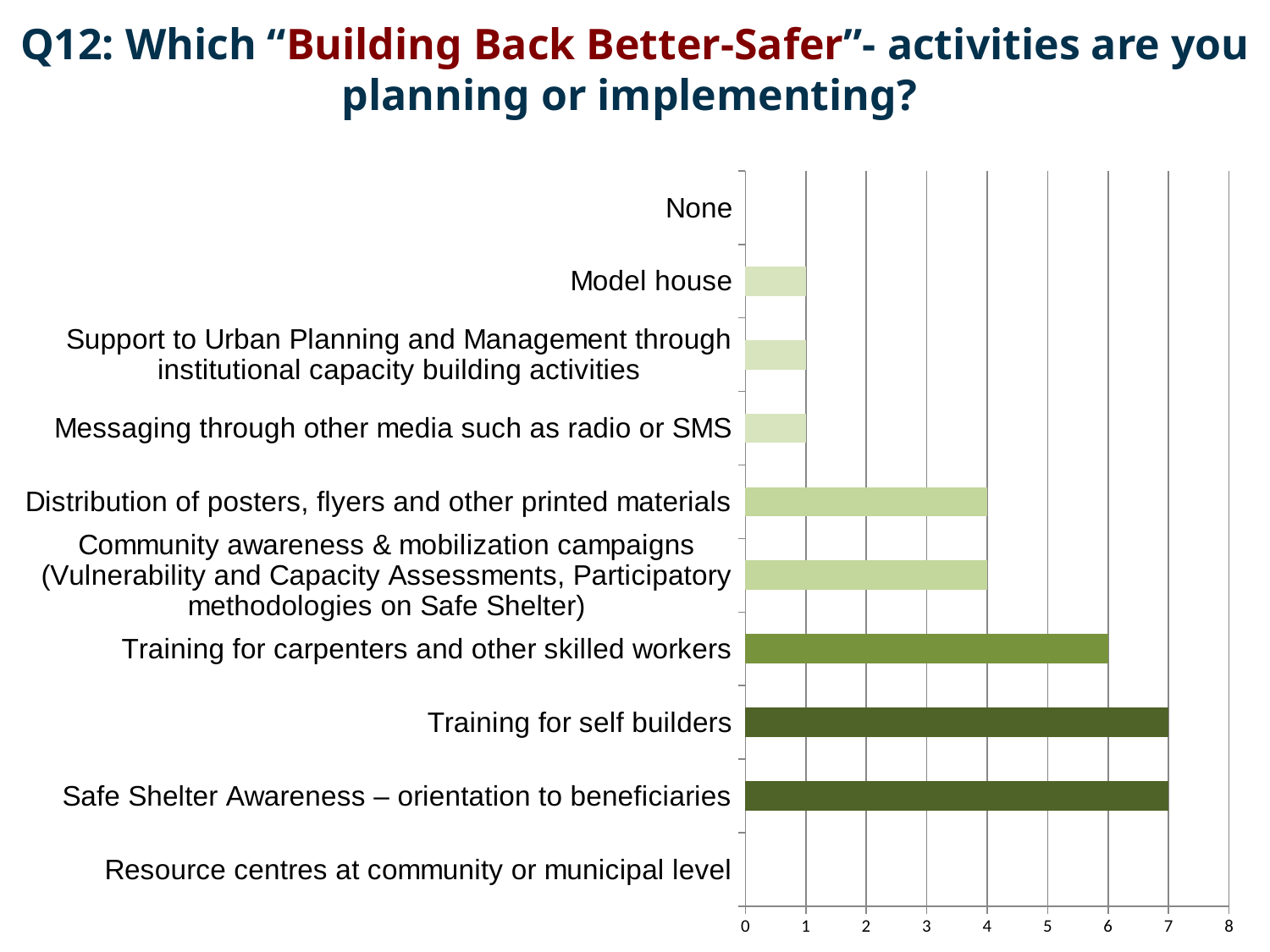
What is the value for "Training for carpenters and other skilled workers"? 6 Which has a larger value: "Training for carpenters and other skilled workers" or "Community awareness & mobilization campaigns"? Training for carpenters and other skilled workers What is the difference between the values for "Safe Shelter Awareness – orientation to beneficiaries" and "Distribution of posters, flyers and other printed materials"? 3 What is the value for "Training for self builders"? 7 What is the value for "Model house"? 1 How many activity categories are listed on the chart? 10 What is the highest value shown on the x axis? 8 What is the difference between the values for "Training for self builders" and "Training for carpenters and other skilled workers"? 1 What kind of chart is shown on the slide? Bar chart What is the value for "Distribution of posters, flyers and other printed materials"? 4 Is the value for "Training for self builders" greater or less than 5? greater What is the value for "Messaging through other media such as radio or SMS"? 1